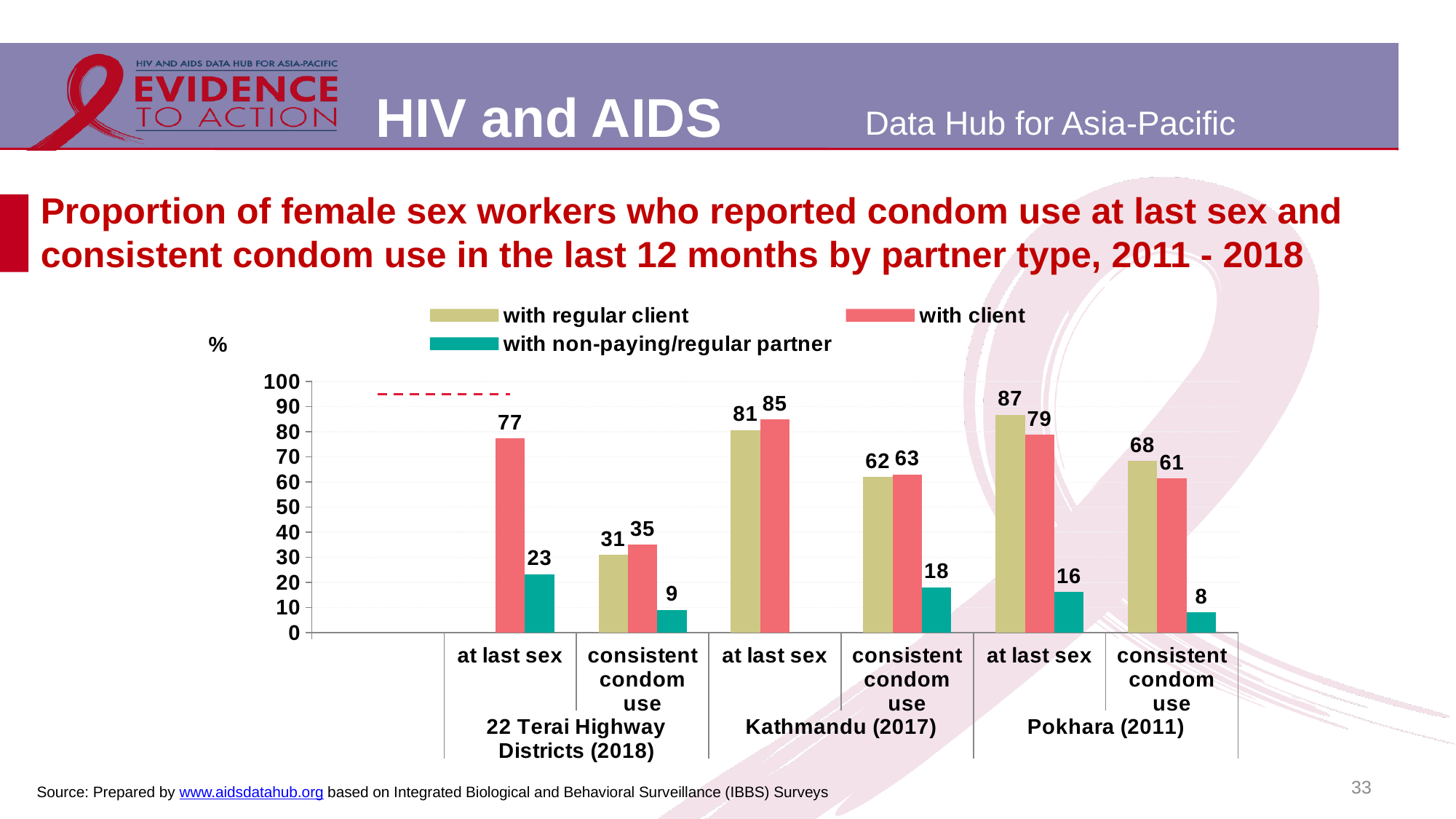
Is the value for 'with non-paying/regular partner' for consistent condom use in 22 Terai Highway Districts (2018) greater or less than 10? less What colour represents 'with non-paying/regular partner' in the chart? teal Which is larger for consistent condom use in Pokhara (2011): 'with regular client' or 'with client'? with regular client What is the difference between 'with client' and 'with non-paying/regular partner' for at last sex in 22 Terai Highway Districts (2018)? 54 What is the value for 'with client' for at last sex in 22 Terai Highway Districts (2018)? 77 How many location groups are shown on the x axis? 3 What is the value for 'with regular client' for at last sex in Kathmandu (2017)? 81 What kind of chart is shown on the slide? bar chart Which series has the highest value for at last sex in Pokhara (2011)? with regular client Which series has the lowest value for consistent condom use in Kathmandu (2017)? with non-paying/regular partner What is the value for 'with non-paying/regular partner' for consistent condom use in Pokhara (2011)? 8 How many series does the legend list? 3